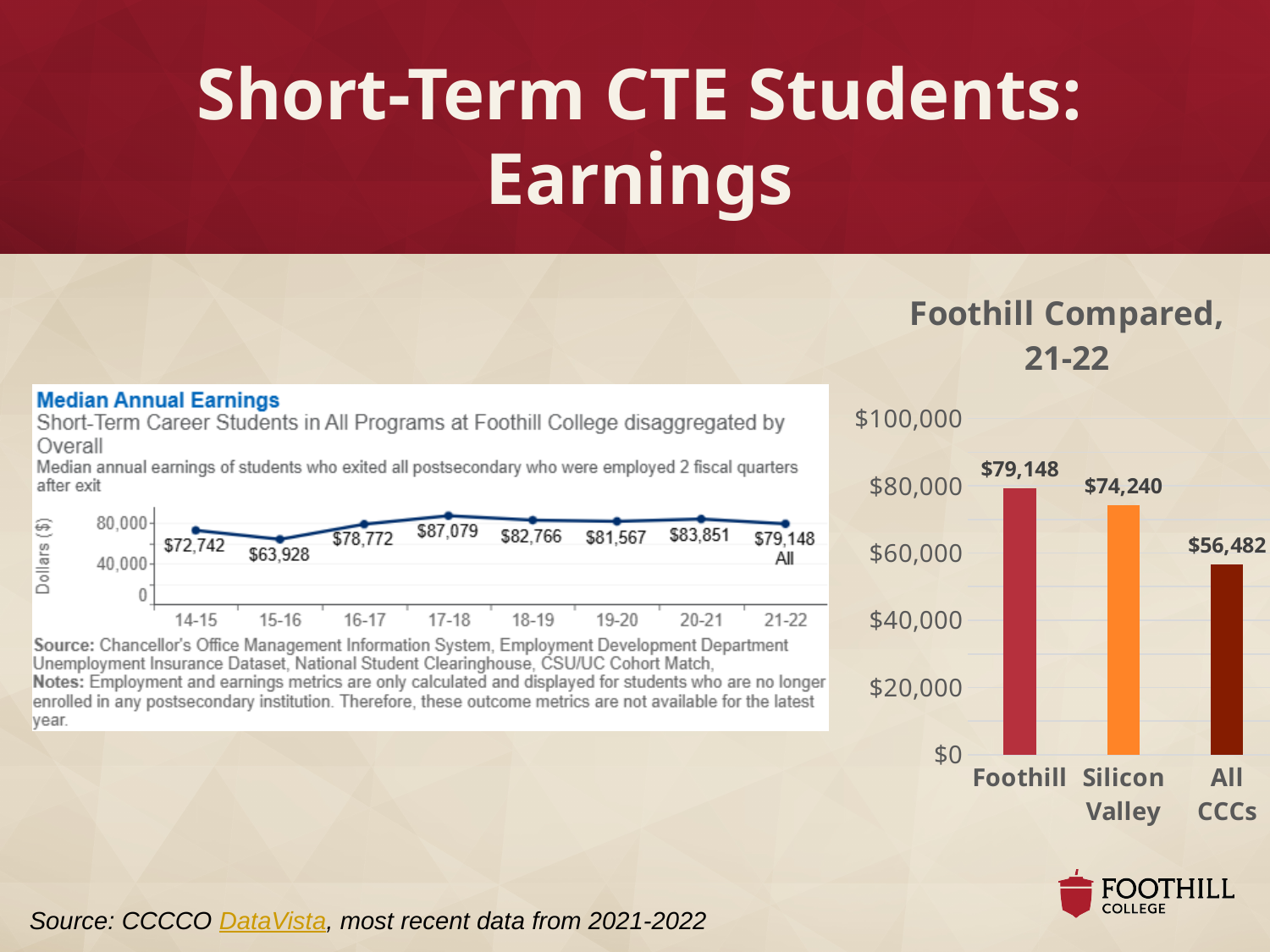
What kind of chart is the 'Median Annual Earnings' chart? Line chart What kind of chart is the 'Foothill Compared, 21-22' chart? Bar chart In the 'Median Annual Earnings' chart, what is the value for 17-18? $87,079 In the 'Foothill Compared, 21-22' chart, what is the difference between the Foothill and All CCCs values? $22,666 In the 'Median Annual Earnings' chart, how many data points are plotted? 8 In the 'Median Annual Earnings' chart, is the value for 19-20 larger or smaller than the value for 20-21? Smaller In the 'Median Annual Earnings' chart, which year has the highest median annual earnings? 17-18 In the 'Median Annual Earnings' chart, which year has the lowest median annual earnings? 15-16 In the 'Foothill Compared, 21-22' chart, how many categories are shown? 3 In the 'Foothill Compared, 21-22' chart, which category has the lowest value? All CCCs In the 'Foothill Compared, 21-22' chart, what is the value for Silicon Valley? $74,240 In the 'Median Annual Earnings' chart, what is the difference between the 21-22 and 14-15 values? $6,406